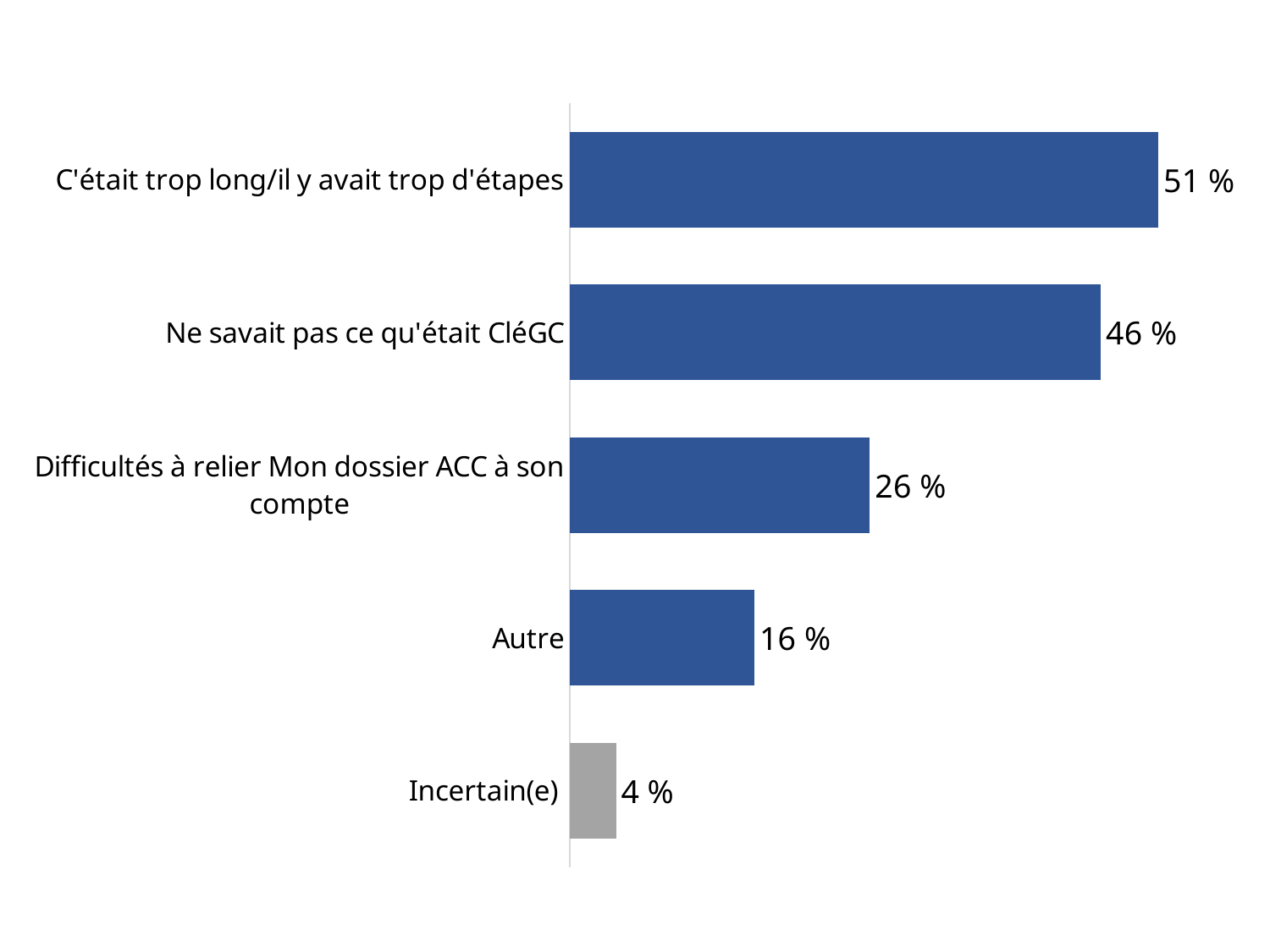
Which category has the highest value? C'était trop long/il y avait trop d'étapes What is the value for "Incertain(e)"? 4 % What is the difference between the values for "Difficultés à relier Mon dossier ACC à son compte" and "Autre"? 10 % Which is larger, the value for "Autre" or the value for "Incertain(e)"? Autre What kind of chart is shown on the slide? Bar chart What is the difference between the values for "C'était trop long/il y avait trop d'étapes" and "Ne savait pas ce qu'était CléGC"? 5 % What is the value for "Ne savait pas ce qu'était CléGC"? 46 % What is the value for "Autre"? 16 % Which category has the lowest value? Incertain(e) What is the value for "C'était trop long/il y avait trop d'étapes"? 51 % What is the value for "Difficultés à relier Mon dossier ACC à son compte"? 26 % How many categories are shown in the chart? 5